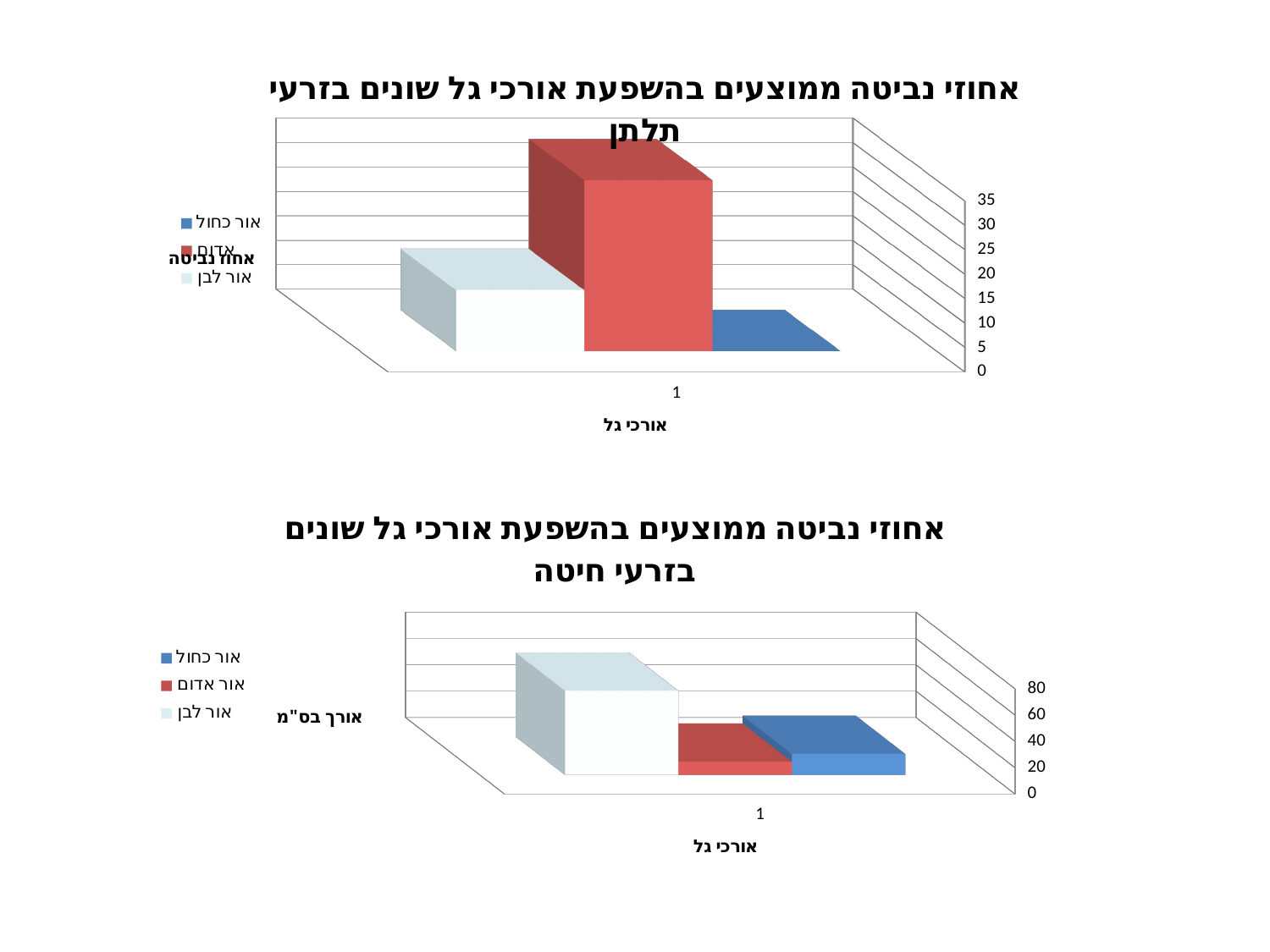
What kind of chart is the bottom chart (wheat seeds)? bar chart In the bottom chart (wheat seeds), is the value for אור לבן greater or less than 40? greater In the bottom chart (wheat seeds), is the value for אור אדום greater or less than 40? less In the bottom chart (wheat seeds), how many series does the legend list? 3 In the bottom chart (wheat seeds), what is the x-axis title? אורכי גל What kind of chart is the top chart (clover seeds)? bar chart In the top chart (clover seeds), is the value for אור לבן greater or less than 20? less In the top chart (clover seeds), how many series does the legend list? 3 In the top chart (clover seeds), which light colour series has the lowest bar? אור כחול In the top chart (clover seeds), which light colour series has the highest bar? אדום In the bottom chart (wheat seeds), which light colour series has the highest bar? אור לבן